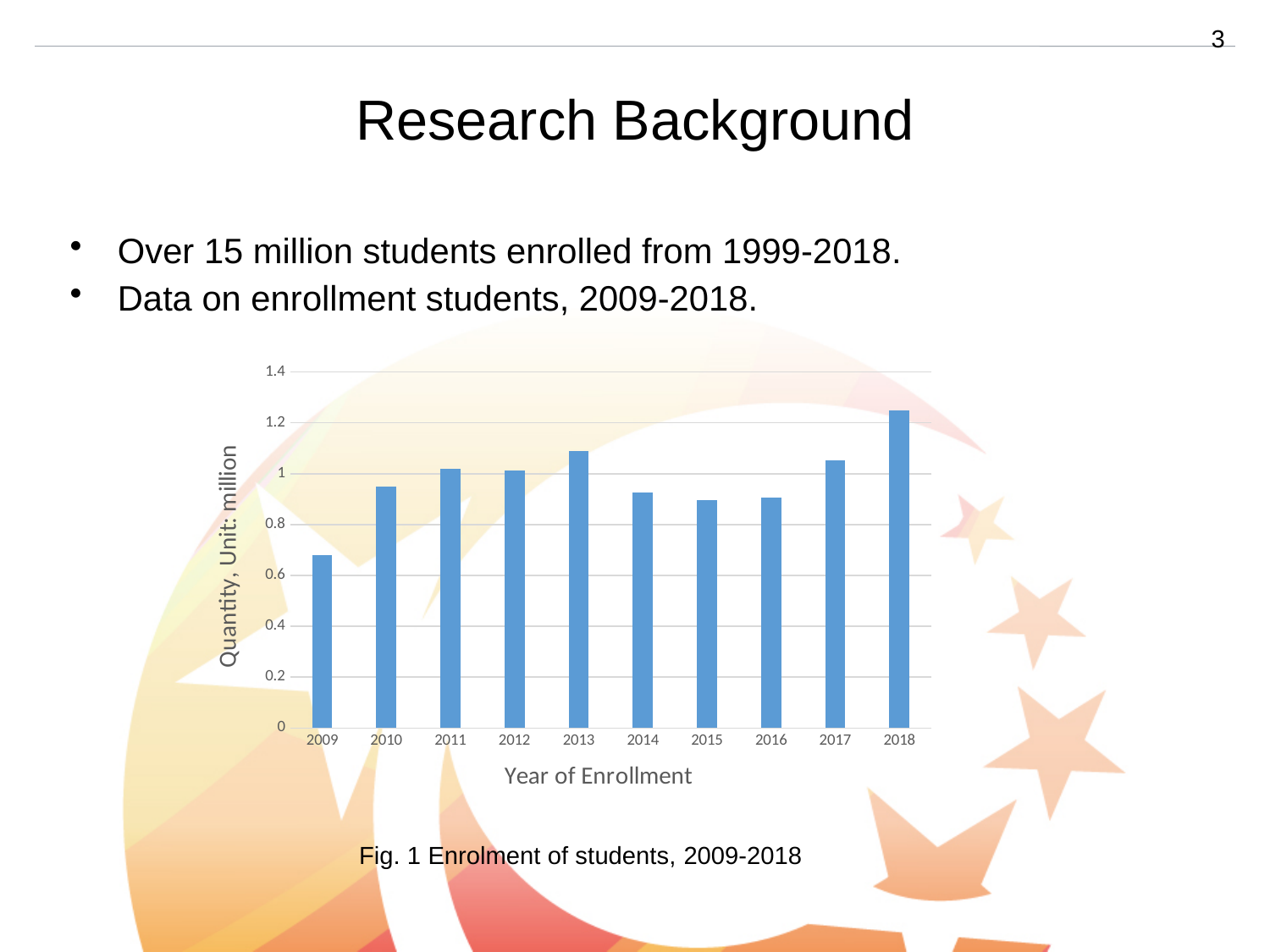
Is the value for 2009 greater or less than 0.8? less Which year has the lowest enrolment in the chart? 2009 Which is larger, the value for 2013 or the value for 2014? 2013 What kind of chart is shown on the slide? bar chart Is the value for 2018 greater or less than 1.2? greater Which year has the highest enrolment in the chart? 2018 Is the value for 2013 greater or less than 1? greater Which is larger, the value for 2009 or the value for 2010? 2010 What is the title of the x axis of the chart? Year of Enrollment How many years are plotted on the x axis of the chart? 10 What is the title of the y axis of the chart? Quantity, Unit: million